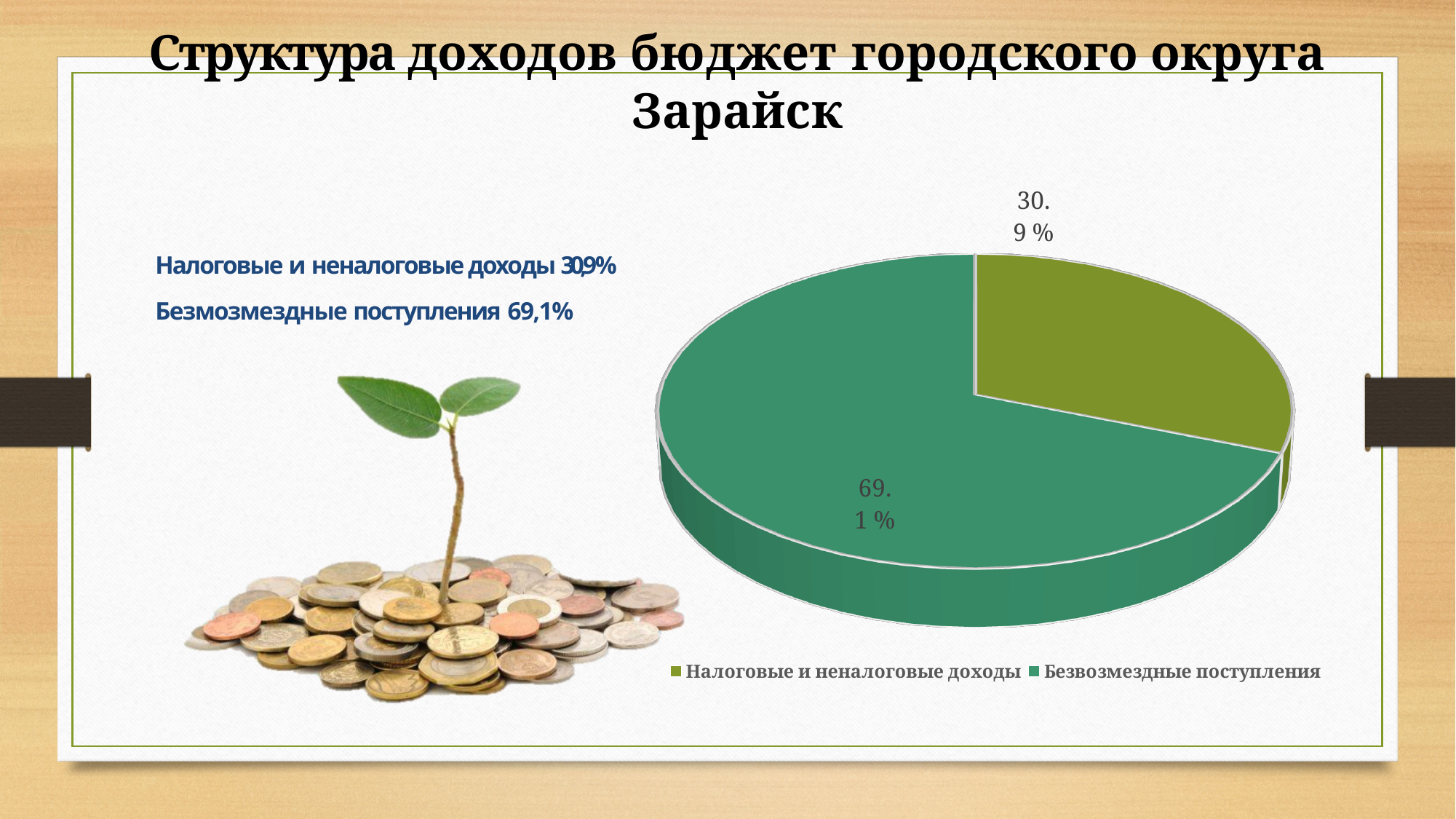
Is the share for "Безвозмездные поступления" greater or less than 50%? greater What colour is the "Безвозмездные поступления" slice in the pie chart? teal green Which slice of the pie is the largest? Безвозмездные поступления Which slice of the pie is the smallest? Налоговые и неналоговые доходы How many entries does the legend of the pie chart list? 2 Which is larger: the share for "Налоговые и неналоговые доходы" or the share for "Безвозмездные поступления"? Безвозмездные поступления What is the title of the slide containing the pie chart? Структура доходов бюджет городского округа Зарайск How many slices does the pie chart have? 2 What share of the pie does "Безвозмездные поступления" have? 69.1 % What kind of chart is shown on the slide? pie chart What is the difference in percentage points between the "Безвозмездные поступления" slice and the "Налоговые и неналоговые доходы" slice? 38.2 What share of the pie does "Налоговые и неналоговые доходы" have? 30.9 %